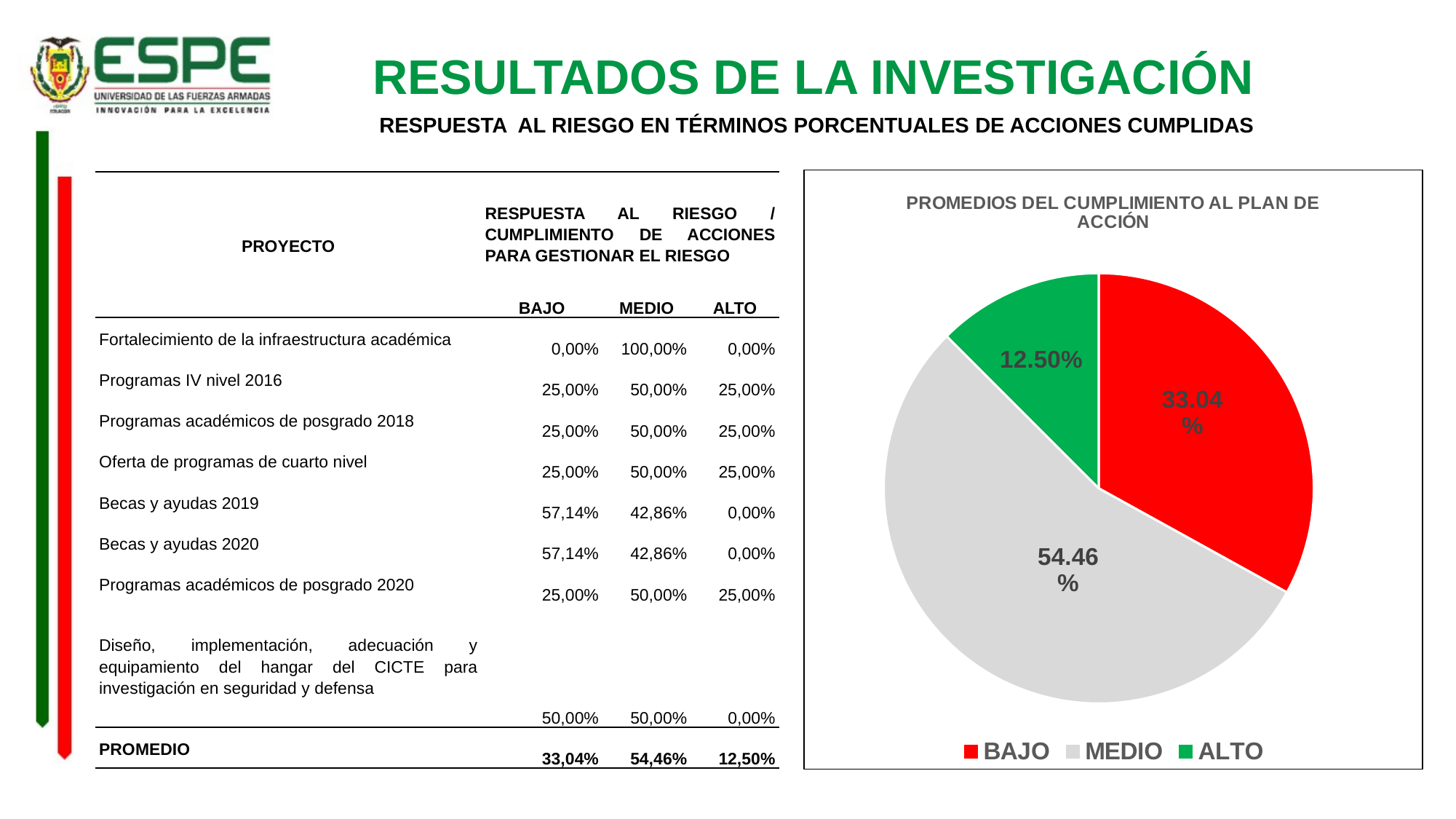
Which is larger in the pie chart, BAJO or ALTO? BAJO What share of the pie does MEDIO represent? 54.46% What is the difference between the BAJO and ALTO slices? 20.54% Which category has the smallest slice of the pie? ALTO Which category has the largest slice of the pie? MEDIO What is the difference between the MEDIO and BAJO slices? 21.42% What is the title of the chart? PROMEDIOS DEL CUMPLIMIENTO AL PLAN DE ACCIÓN How many slices does the pie chart have? 3 What type of chart is shown on the slide? Pie chart What colour is the MEDIO slice in the pie chart? Grey What is the value shown for ALTO in the pie chart? 12.50% What is the value shown for BAJO in the pie chart? 33.04%